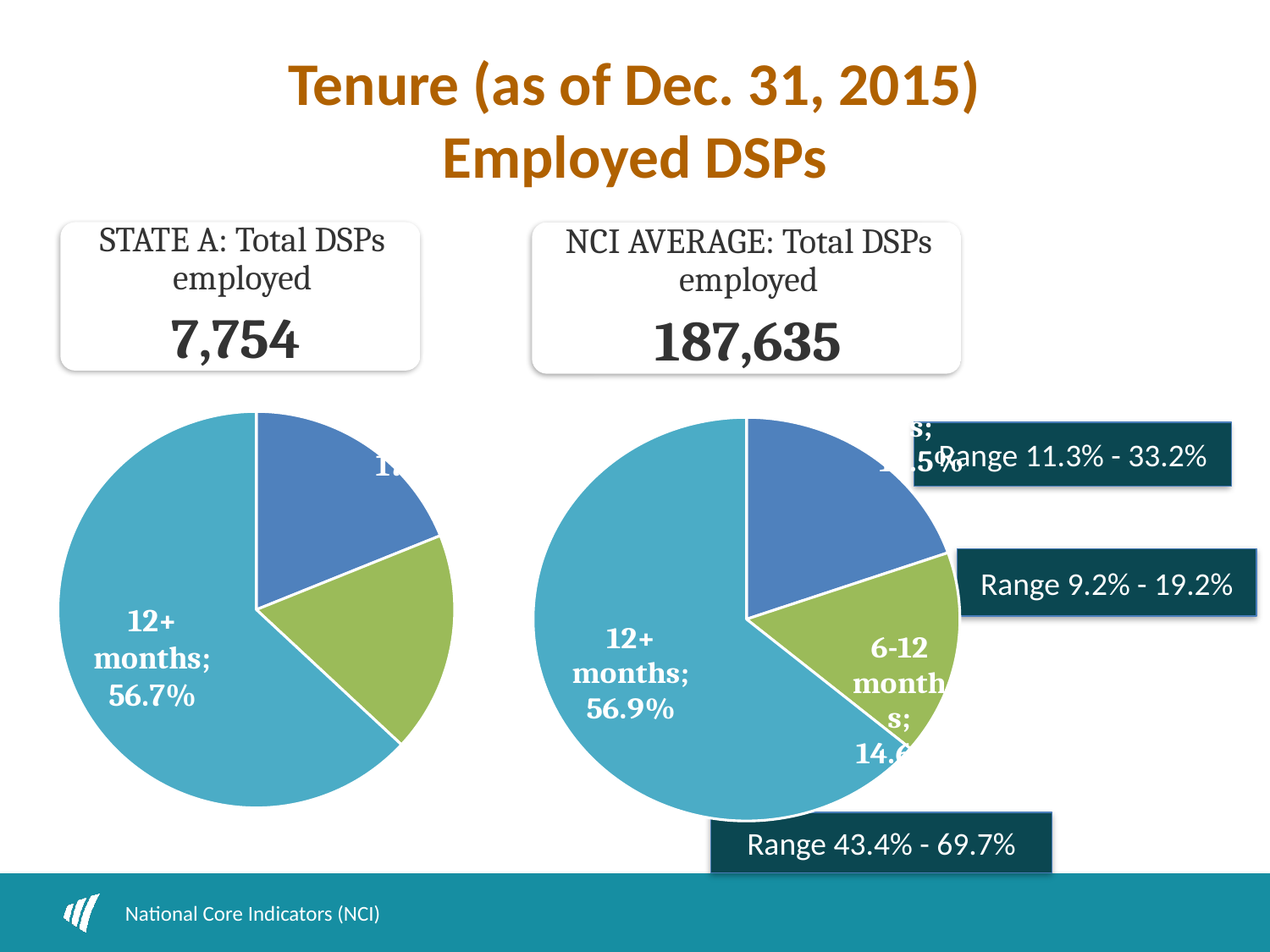
In the NCI AVERAGE pie chart (right), which tenure category has the smallest share? 6-12 months What kind of chart is used on this slide to show DSP tenure? Pie chart What is the difference between the 12+ months share in the NCI AVERAGE pie chart (56.9%) and in the STATE A pie chart (56.7%)? 0.2 percentage points In the NCI AVERAGE pie chart (right), which tenure category has the largest share? 12+ months In the STATE A pie chart (left), what percentage of DSPs have 12+ months of tenure? 56.7% What range is shown next to the NCI AVERAGE pie chart for the 12+ months category? Range 43.4% - 69.7% Which is larger: the 12+ months share in the STATE A pie chart or in the NCI AVERAGE pie chart? NCI AVERAGE In the STATE A pie chart (left), which tenure category has the largest share? 12+ months In the NCI AVERAGE pie chart (right), what percentage of DSPs have 12+ months of tenure? 56.9% How many slices does the STATE A pie chart (left) have? 3 How many slices does the NCI AVERAGE pie chart (right) have? 3 In the STATE A pie chart (left), is the 12+ months share greater or less than 50%? greater